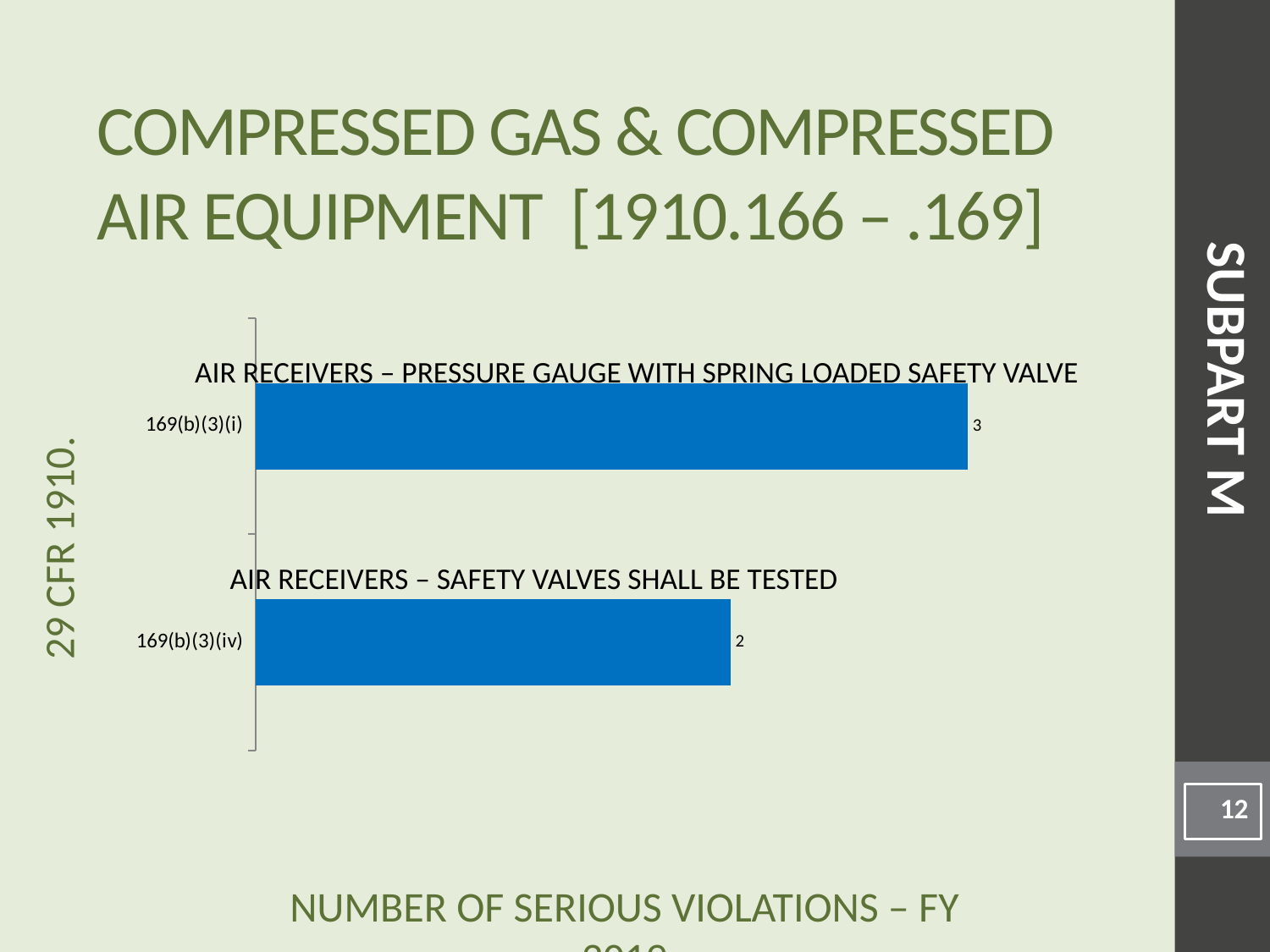
What is the number of serious violations for 169(b)(3)(i)? 3 How many categories are shown in the chart? 2 What is the number of serious violations for 169(b)(3)(iv)? 2 What is the difference between the values for 169(b)(3)(i) and 169(b)(3)(iv)? 1 Which category has the highest number of serious violations? 169(b)(3)(i) Which category has the lowest number of serious violations? 169(b)(3)(iv) What colour are the bars in the chart? Blue What is the total number of serious violations across both categories? 5 What is the description shown above the bar for 169(b)(3)(iv)? AIR RECEIVERS – SAFETY VALVES SHALL BE TESTED What kind of chart is shown on the slide? Bar chart Which has more serious violations, 169(b)(3)(i) or 169(b)(3)(iv)? 169(b)(3)(i)